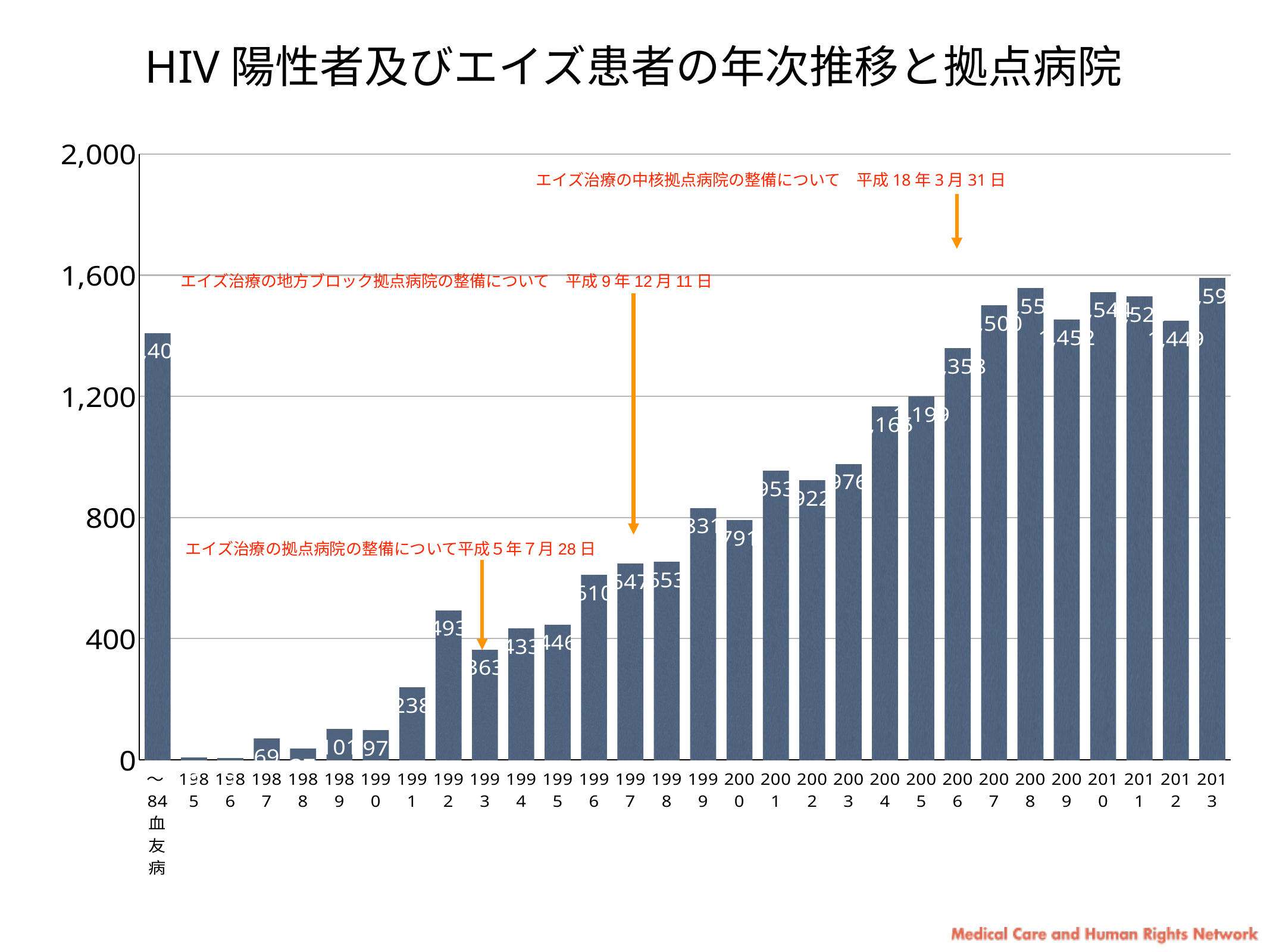
What is the difference between the values for 1992 and 1993? 130 Is the value for 1985 greater or less than 400? less What is the value for 2007? 1,500 What is the value for 1991? 238 What is the value for 2012? 1,449 What kind of chart is shown on the slide? bar chart Which is larger, the value for 1999 or the value for 2000? 1999 What is the value for 1999? 831 Do the values generally rise or fall from 1985 to 2013? rise What is the value for 1992? 493 What is the value for 1993? 363 What is the difference between the values for 2003 and 2002? 54